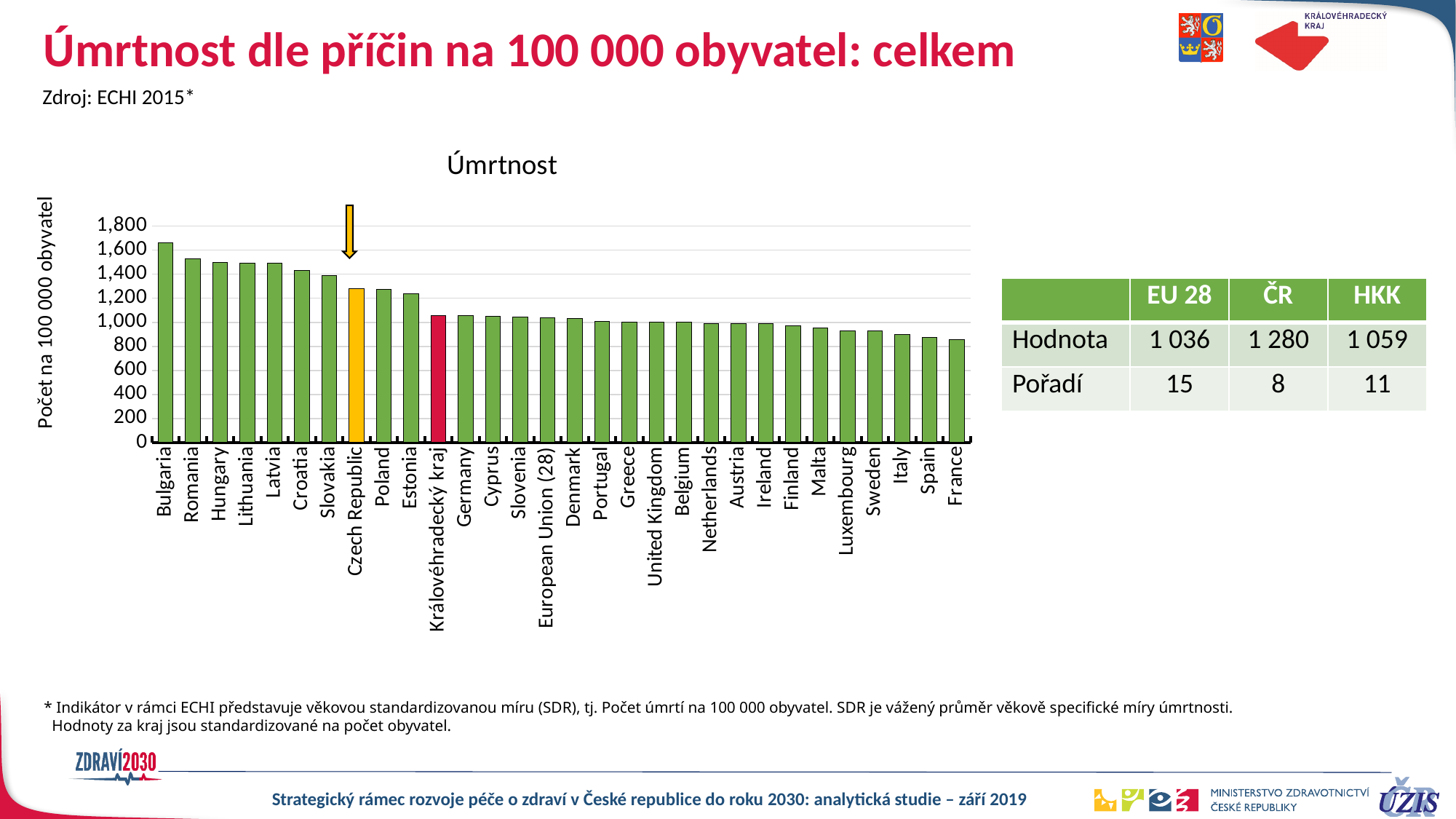
According to the table, what is the value (Hodnota) for EU 28? 1 036 What is the difference between the values for ČR and EU 28 shown in the table? 244 What is the title of the chart? Úmrtnost How many countries/regions are plotted on the x axis of the chart? 30 According to the table, what is the value (Hodnota) for ČR? 1 280 Which country has the highest mortality value in the chart? Bulgaria According to the table, what is the rank (Pořadí) of HKK? 11 What colour is the bar for Královéhradecký kraj? red Which is larger, the value for Czech Republic or for Královéhradecký kraj? Czech Republic Is the value for France greater or less than 1,000? less What type of chart is shown on the slide? bar chart Do the values generally rise or fall from left to right along the x axis? fall